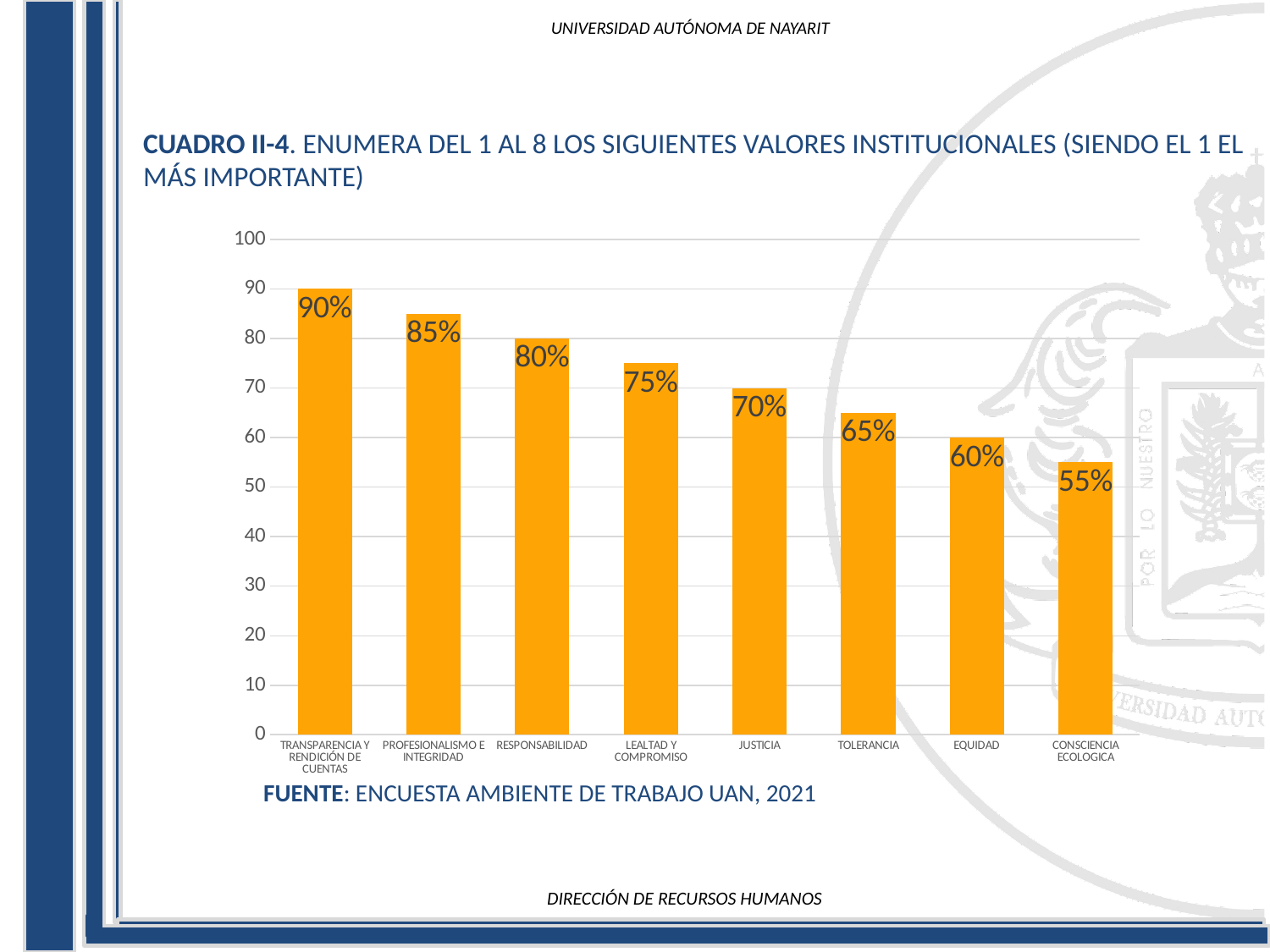
Which is larger, the value for LEALTAD Y COMPROMISO or the value for EQUIDAD? LEALTAD Y COMPROMISO What is the difference between the values for PROFESIONALISMO E INTEGRIDAD and TOLERANCIA? 20% What is the value for JUSTICIA? 70% What kind of chart is shown on the slide? bar chart Do the values rise or fall from left to right along the x axis? fall What is the value for CONSCIENCIA ECOLOGICA? 55% Which category has the lowest value? CONSCIENCIA ECOLOGICA Which category has the highest value? TRANSPARENCIA Y RENDICIÓN DE CUENTAS Is the value for RESPONSABILIDAD greater or less than 70? greater How many categories are shown on the x axis? 8 What is the value for TRANSPARENCIA Y RENDICIÓN DE CUENTAS? 90% What source is cited below the chart? ENCUESTA AMBIENTE DE TRABAJO UAN, 2021